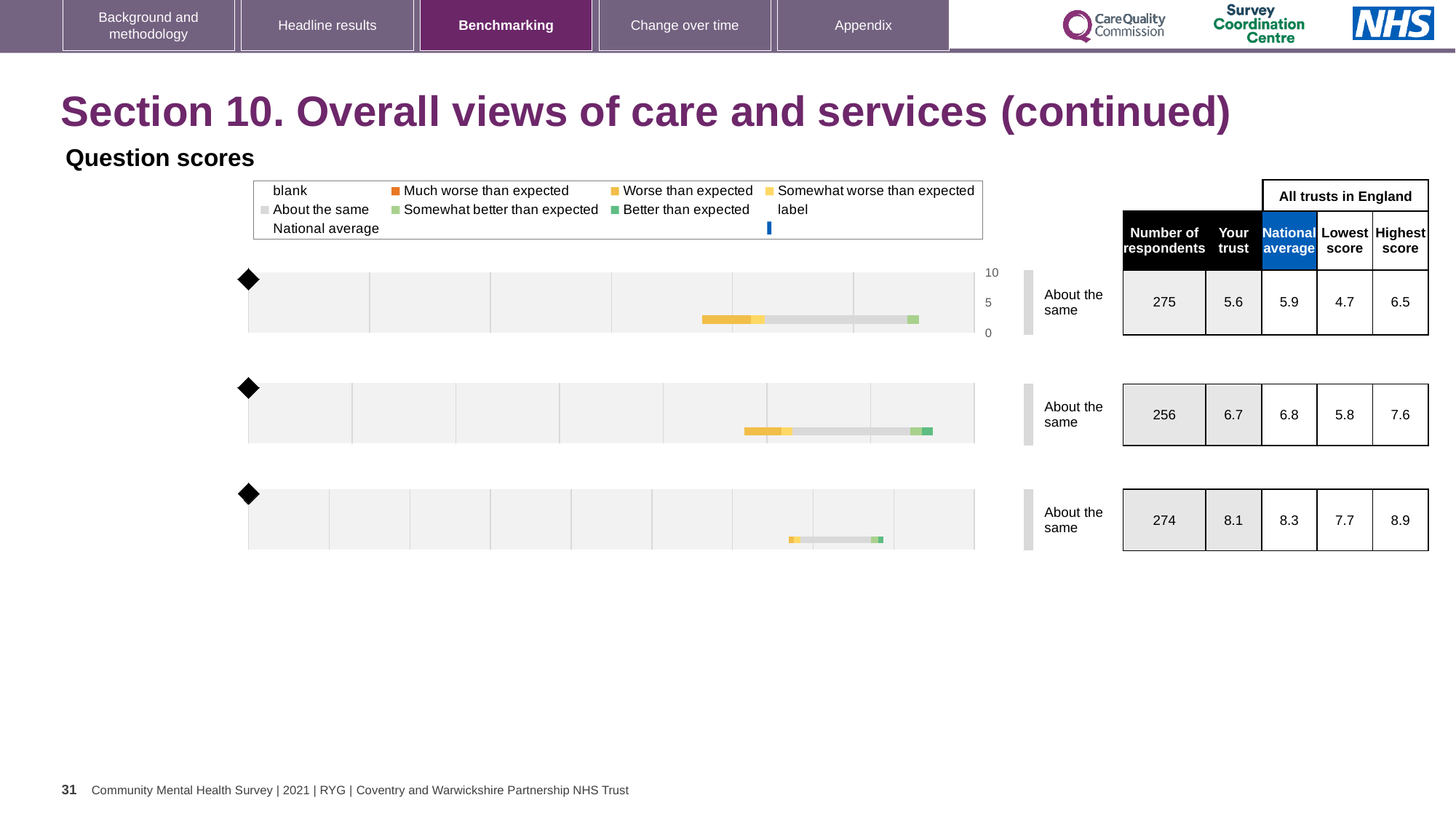
What benchmark rating is given to each of the three chart rows? About the same For the top chart row, what is the national average score? 5.9 For the bottom chart row, which is larger: the 'Your trust' score or the national average? National average Which chart row (top, middle or bottom) has the highest 'Your trust' score? bottom For the top chart row, what is the lowest score among all trusts in England? 4.7 How many question score bar charts are shown on the slide? 3 For the bottom chart row, what is the highest score among all trusts in England? 8.9 What kind of chart is used to show the question scores on this slide? bar chart What colour does the legend use for 'Much worse than expected'? orange For the top chart row, what is the 'Your trust' score shown in the table? 5.6 For the middle chart row, how many respondents are listed? 256 For the middle chart row, what is the difference between the highest score and the lowest score? 1.8